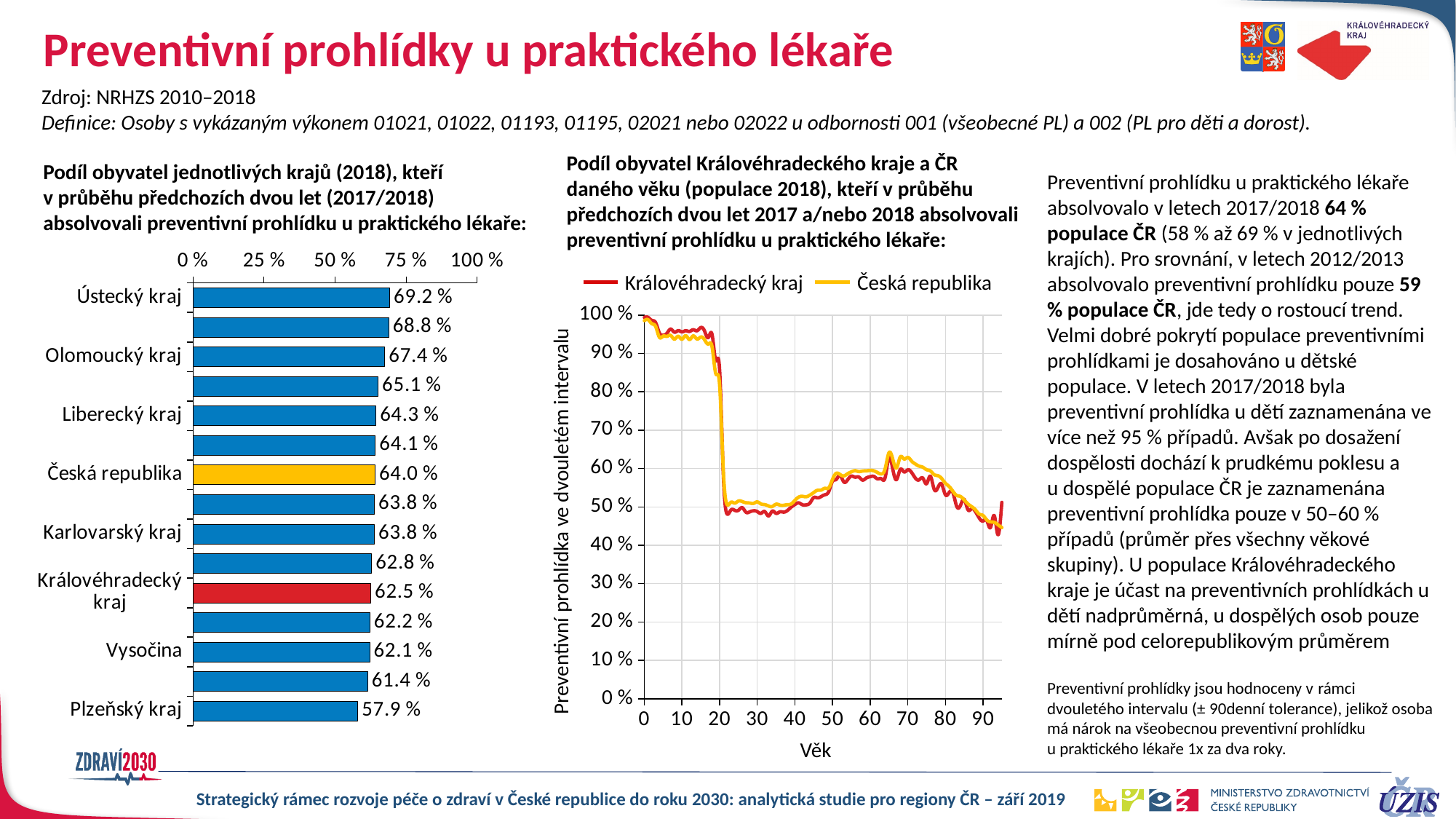
In the left bar chart, which is larger: the value for Olomoucký kraj or the value for Karlovarský kraj? Olomoucký kraj In the left bar chart, what is the difference between the values for Ústecký kraj and Plzeňský kraj? 11.3 % In the left bar chart, what is the value for Ústecký kraj? 69.2 % In the left bar chart, what is the value for Česká republika? 64.0 % In the left bar chart, which labelled category has the highest value? Ústecký kraj In the right line chart, is the value for Česká republika at age 10 greater or less than 80 %? greater In the left bar chart, what is the value for Královéhradecký kraj? 62.5 % How many series does the legend of the right line chart list? 2 In the right line chart, is the value for Královéhradecký kraj at age 40 greater or less than 60 %? less How many bars are plotted in the left bar chart? 15 What kind of chart is the chart on the left of the slide? Bar chart In the left bar chart, which labelled category has the lowest value? Plzeňský kraj